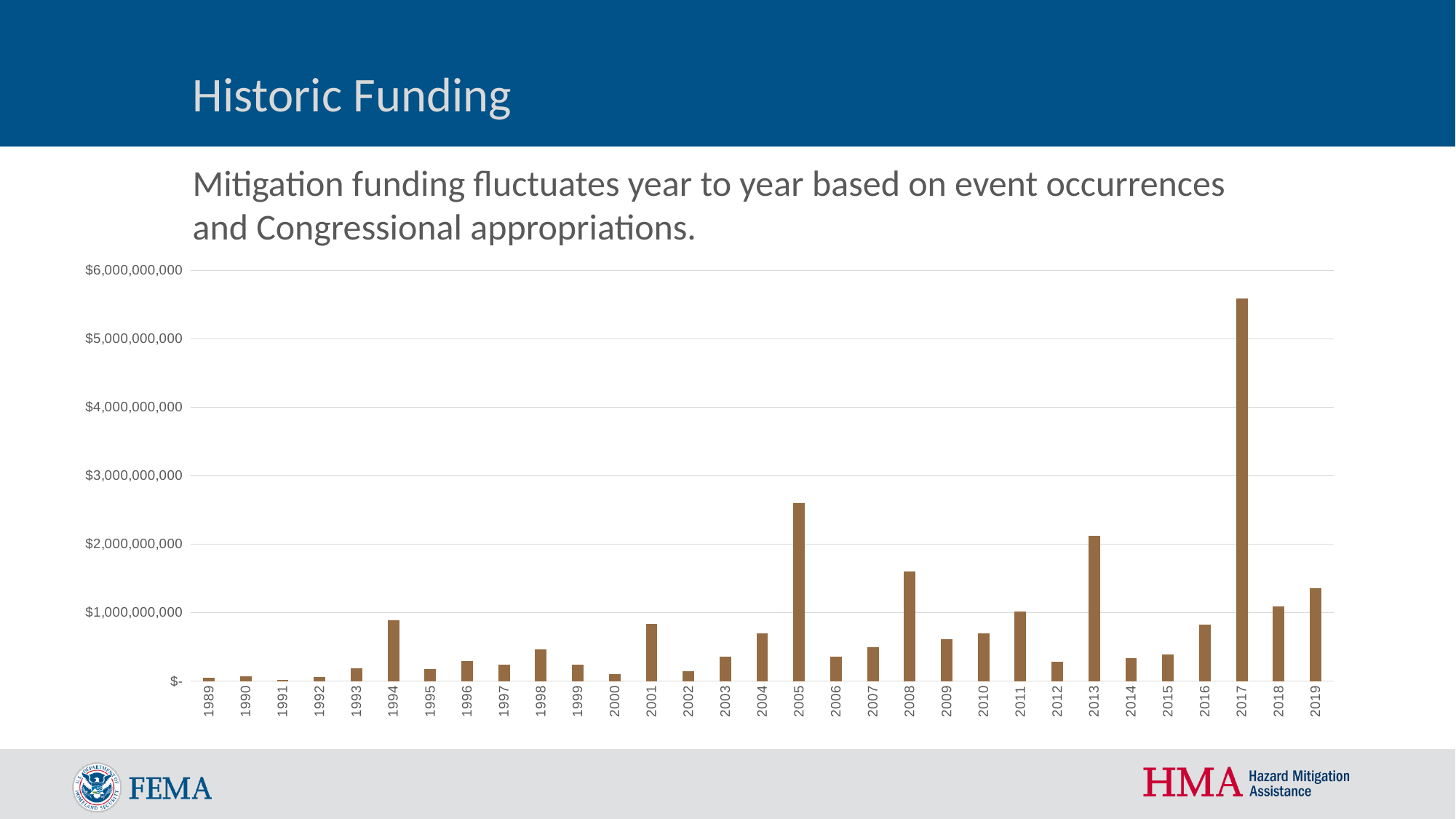
Is the value for 2005 greater or less than $2,000,000,000? greater Is the value for 2013 greater or less than $3,000,000,000? less What kind of chart is shown on the slide? bar chart Which year has the larger funding value, 2008 or 2019? 2008 Is the value for 2017 greater or less than $5,000,000,000? greater How many years are plotted on the x axis of the chart? 31 What is the highest value shown on the y axis of the chart? $6,000,000,000 Which year has the highest funding in the chart? 2017 Which year has the larger funding value, 2005 or 2013? 2005